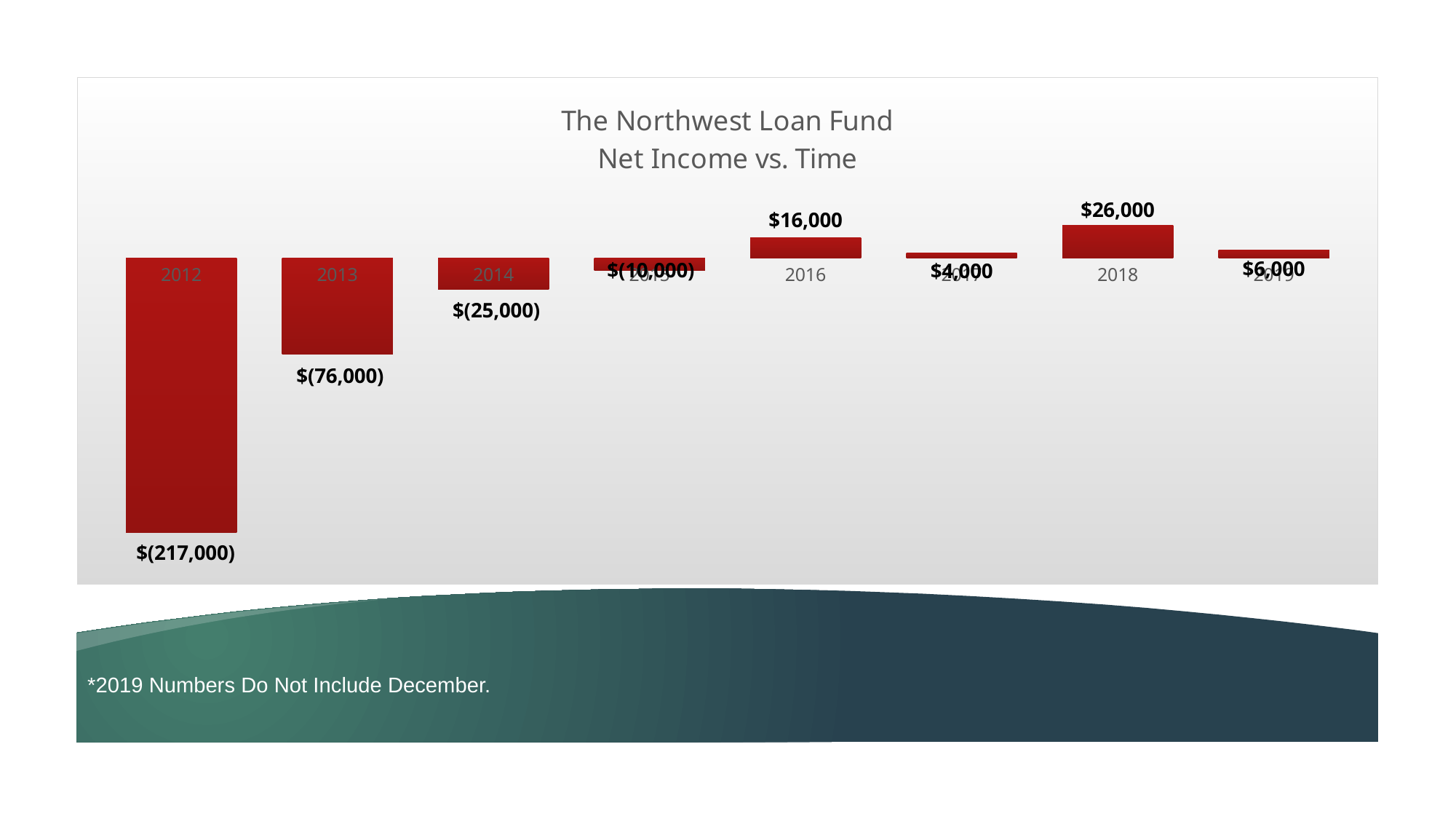
What kind of chart is shown on the slide? Bar chart What is the net income value shown for 2018? $26,000 Which year has the larger net income, 2016 or 2017? 2016 What is the difference between the net income in 2018 and in 2016? $10,000 What is the net income value shown for 2016? $16,000 How many years are plotted in the chart? 8 What is the net income value shown for 2012? $(217,000) What is the net income value shown for 2014? $(25,000) Which year has the lowest net income? 2012 What is the title of the chart? The Northwest Loan Fund Net Income vs. Time Which year has the highest net income? 2018 Does net income generally rise or fall from 2012 to 2018? Rise